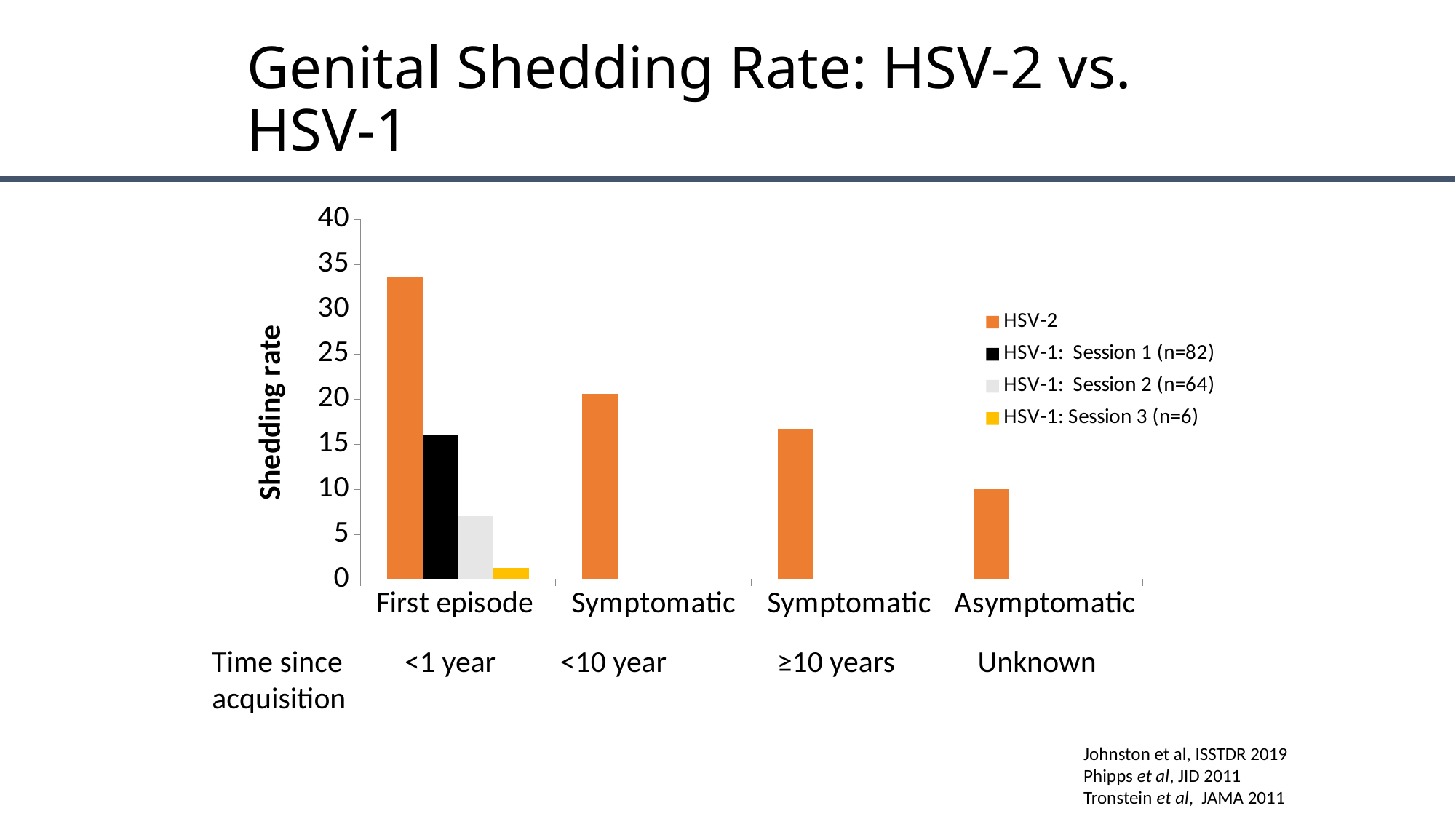
Is the HSV-1: Session 3 (n=6) value for First episode greater or less than 5? less How many categories are shown along the x axis? 4 How many series does the legend list? 4 Which category has the highest HSV-2 shedding rate? First episode Is the HSV-2 value for First episode greater or less than 30? greater Is the HSV-2 value for Symptomatic (<10 year) greater or less than 25? less What kind of chart is shown on the slide? bar chart In the First episode category, which is larger: the HSV-2 value or the HSV-1: Session 1 (n=82) value? HSV-2 Do the HSV-2 values rise or fall from left to right across the categories? fall Which category has the lowest HSV-2 shedding rate? Asymptomatic What is the label on the vertical axis? Shedding rate